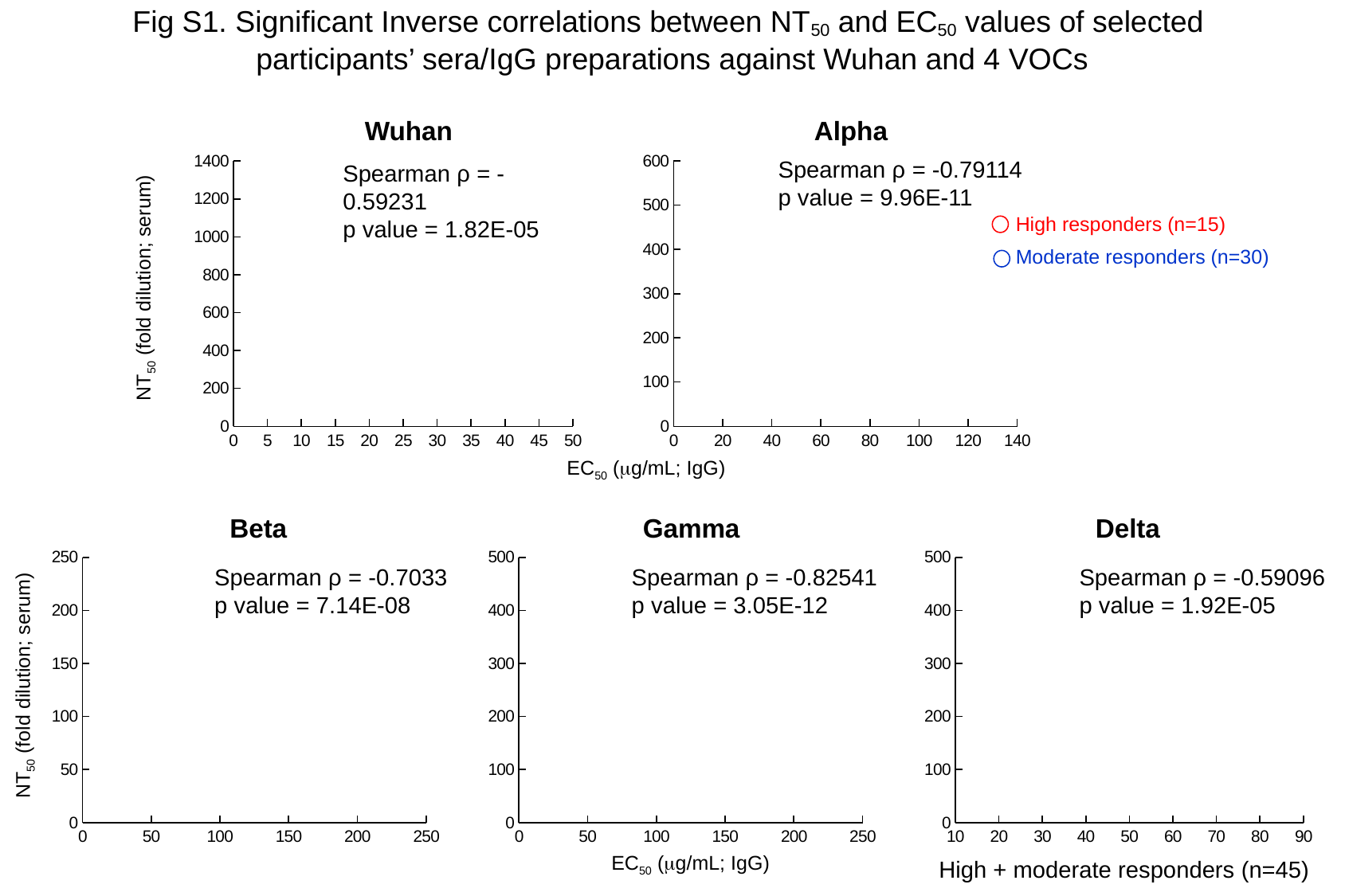
In the Delta chart, what Spearman ρ value is printed? -0.59096 Which chart on the slide reports the Spearman ρ with the smallest magnitude? Delta Is the printed p value in the Beta chart larger or smaller than the printed p value in the Gamma chart? larger In the Beta chart, what Spearman ρ value is printed? -0.7033 In the Gamma chart, what p value is printed? 3.05E-12 Which chart on the slide reports the Spearman ρ with the largest magnitude? Gamma In the Alpha chart, what p value is printed? 9.96E-11 In the Wuhan chart, what Spearman ρ value is printed? -0.59231 What are the two legend entries shown on the slide? High responders (n=15) and Moderate responders (n=30) How many series does the legend list on the slide? 2 What are the titles of the five charts on the slide? Wuhan, Alpha, Beta, Gamma, Delta